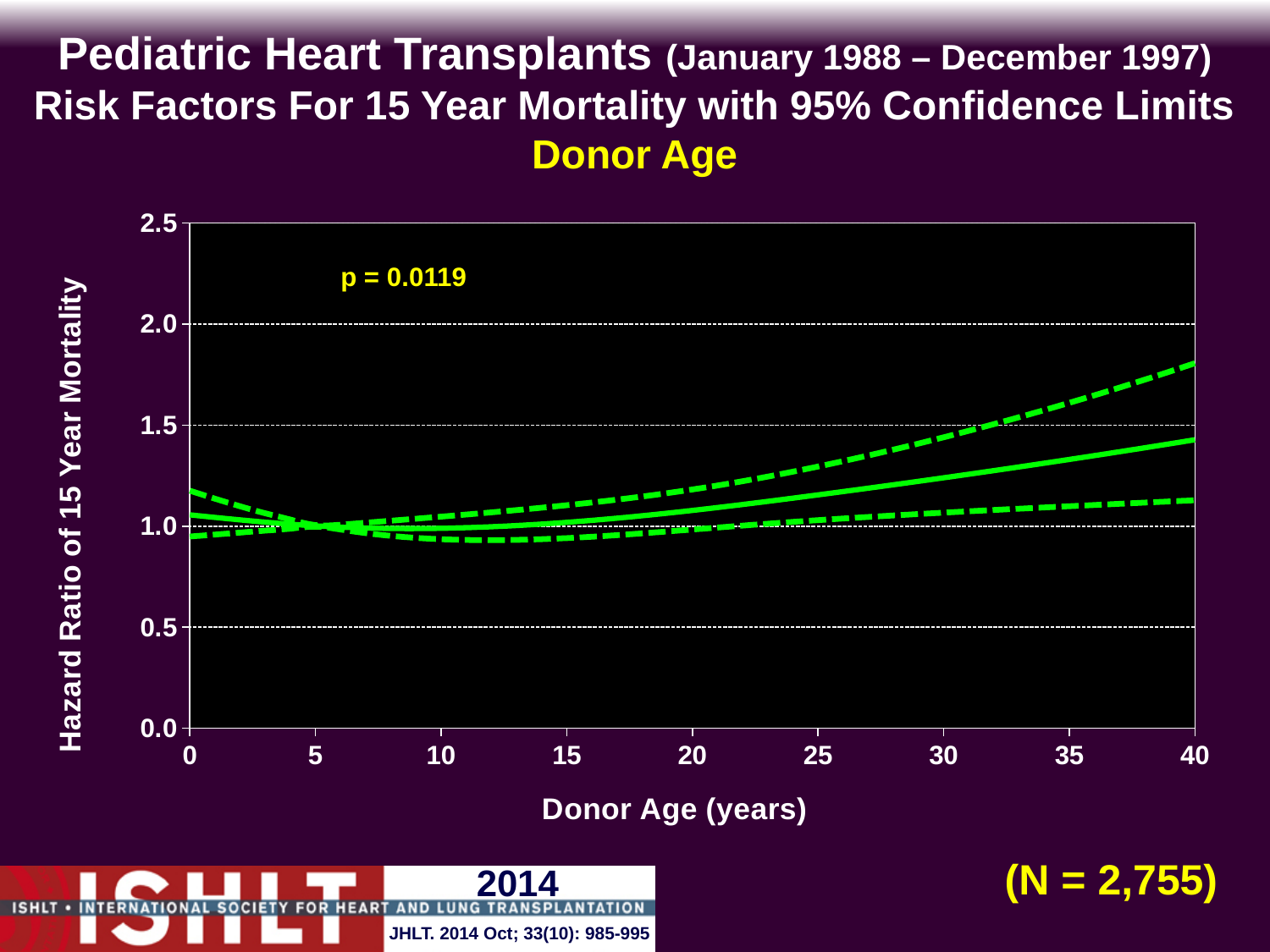
Is the solid hazard ratio line at donor age 40 greater or less than 1.0? greater What sample size (N) is shown on the slide? N = 2,755 Is the lower dashed confidence limit at donor age 40 greater or less than 1.5? less Does the solid hazard ratio line rise or fall as donor age increases from 20 to 40 years? rises Is the upper dashed confidence limit at donor age 30 greater or less than 1.0? greater What p-value is printed on the chart? p = 0.0119 What kind of chart is shown on the slide? line chart How many lines are plotted on the chart? 3 Is the solid hazard ratio line higher at donor age 40 or at donor age 10? donor age 40